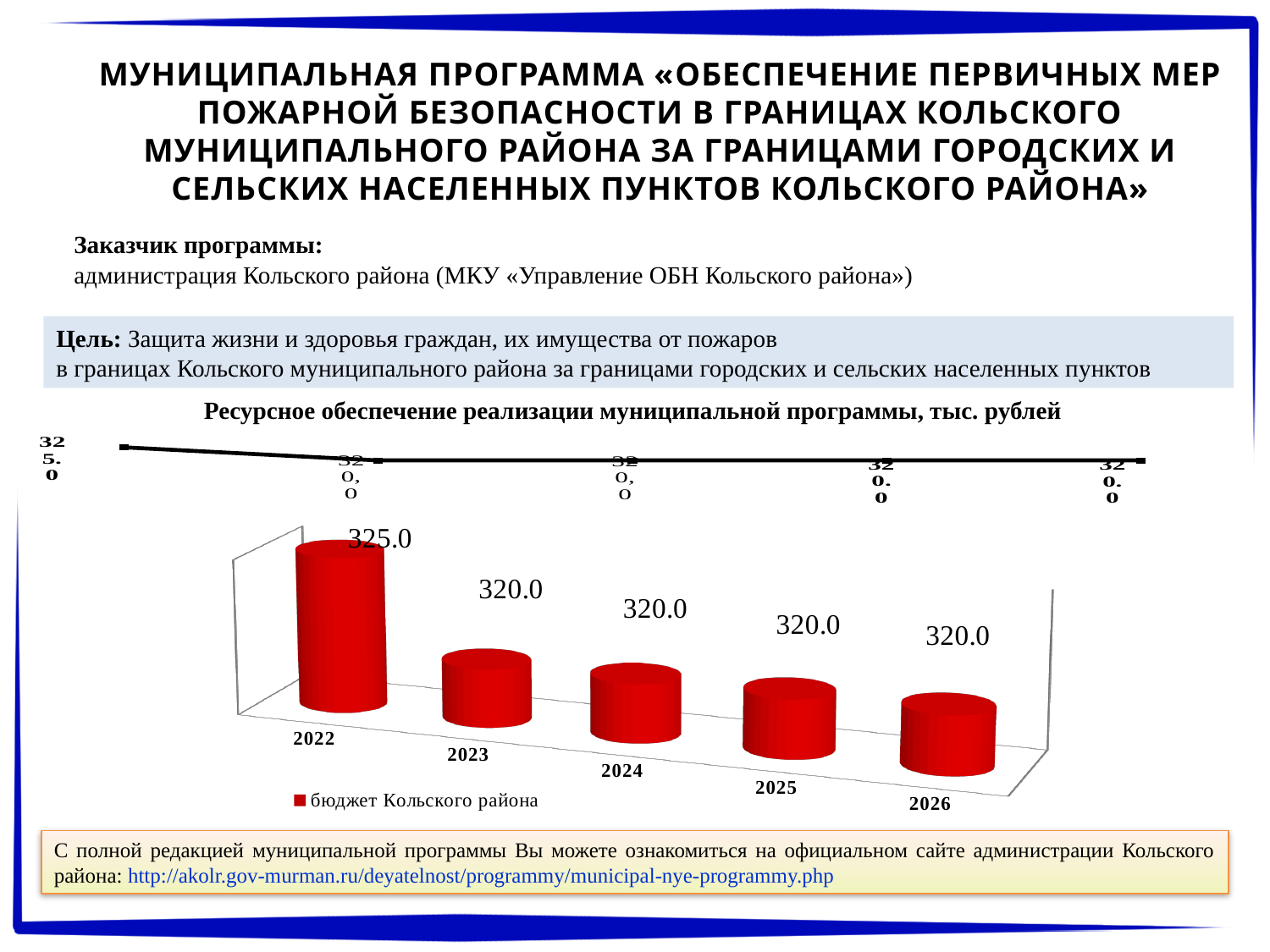
Which year has the highest value in the chart? 2022 What unit is stated in the chart title? тыс. рублей What kind of chart is shown on the slide? bar chart What is the legend entry of the chart? бюджет Кольского района Which is larger, the value for 2022 or the value for 2025? 2022 What is the difference between the values for 2022 and 2023? 5.0 What is the value for 2026 in the chart? 320.0 How many series does the chart legend list? 1 Do the values rise or fall from 2022 to 2023? fall What is the value for 2022 in the chart? 325.0 What is the value for 2024 in the chart? 320.0 How many years are shown in the chart? 5